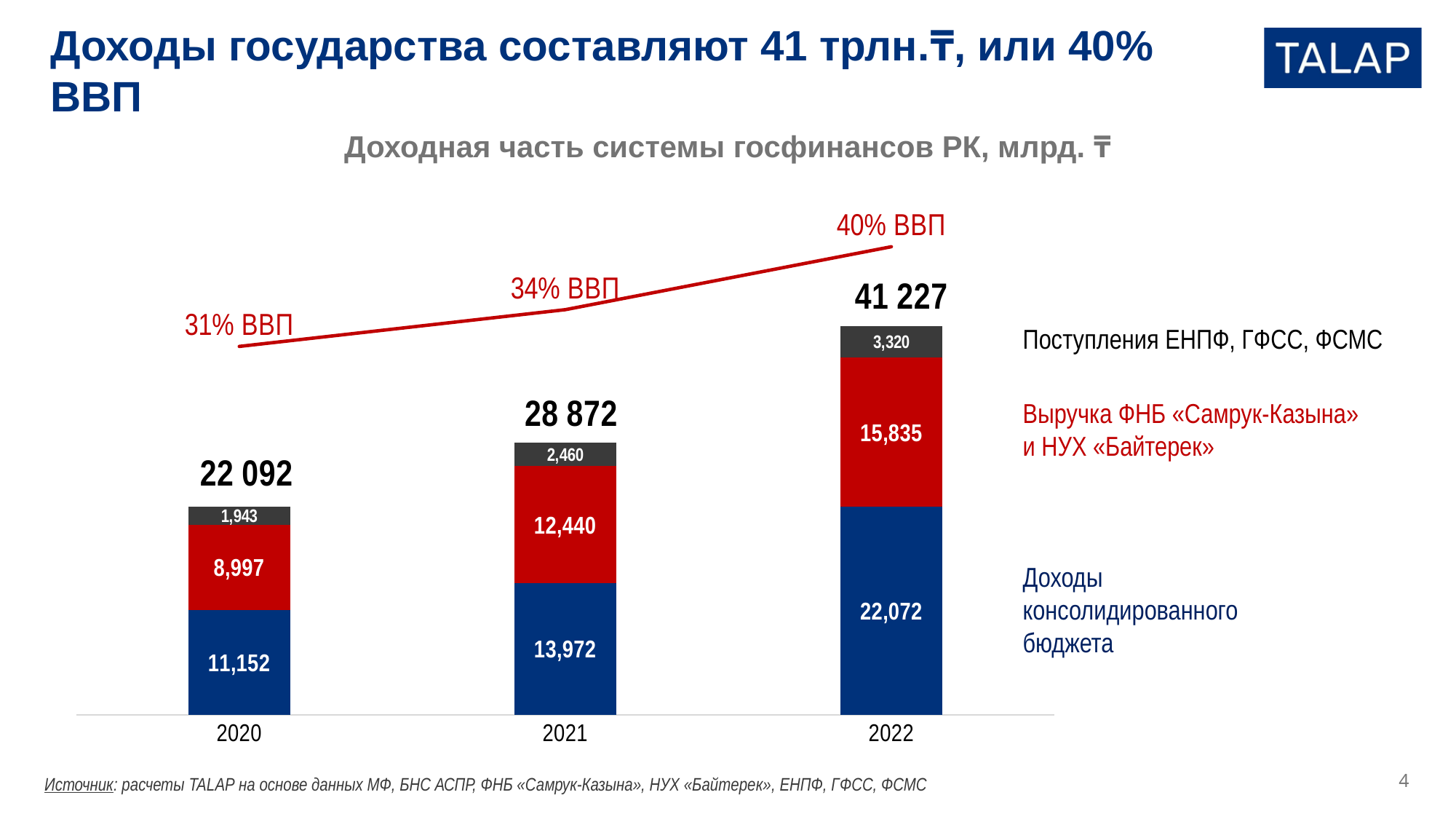
Which year has the highest total revenue? 2022 What share of GDP (ВВП) is shown for 2022? 40% ВВП What is the difference between the Выручка ФНБ «Самрук-Казына» и НУХ «Байтерек» values for 2022 and 2021? 3,395 What is the value of Выручка ФНБ «Самрук-Казына» и НУХ «Байтерек» for 2021? 12,440 Which is larger: Поступления ЕНПФ, ГФСС, ФСМС in 2021 or in 2022? 2022 What is the value of Доходы консолидированного бюджета for 2022? 22,072 What is the total of the stacked bar for 2021? 28 872 Do the total revenues rise or fall from 2020 to 2022? Rise How many years are shown on the x axis? 3 Which year has the lowest value for Доходы консолидированного бюджета? 2020 What type of chart is shown on the slide? Combination stacked bar and line chart What is the value of Поступления ЕНПФ, ГФСС, ФСМС for 2020? 1,943